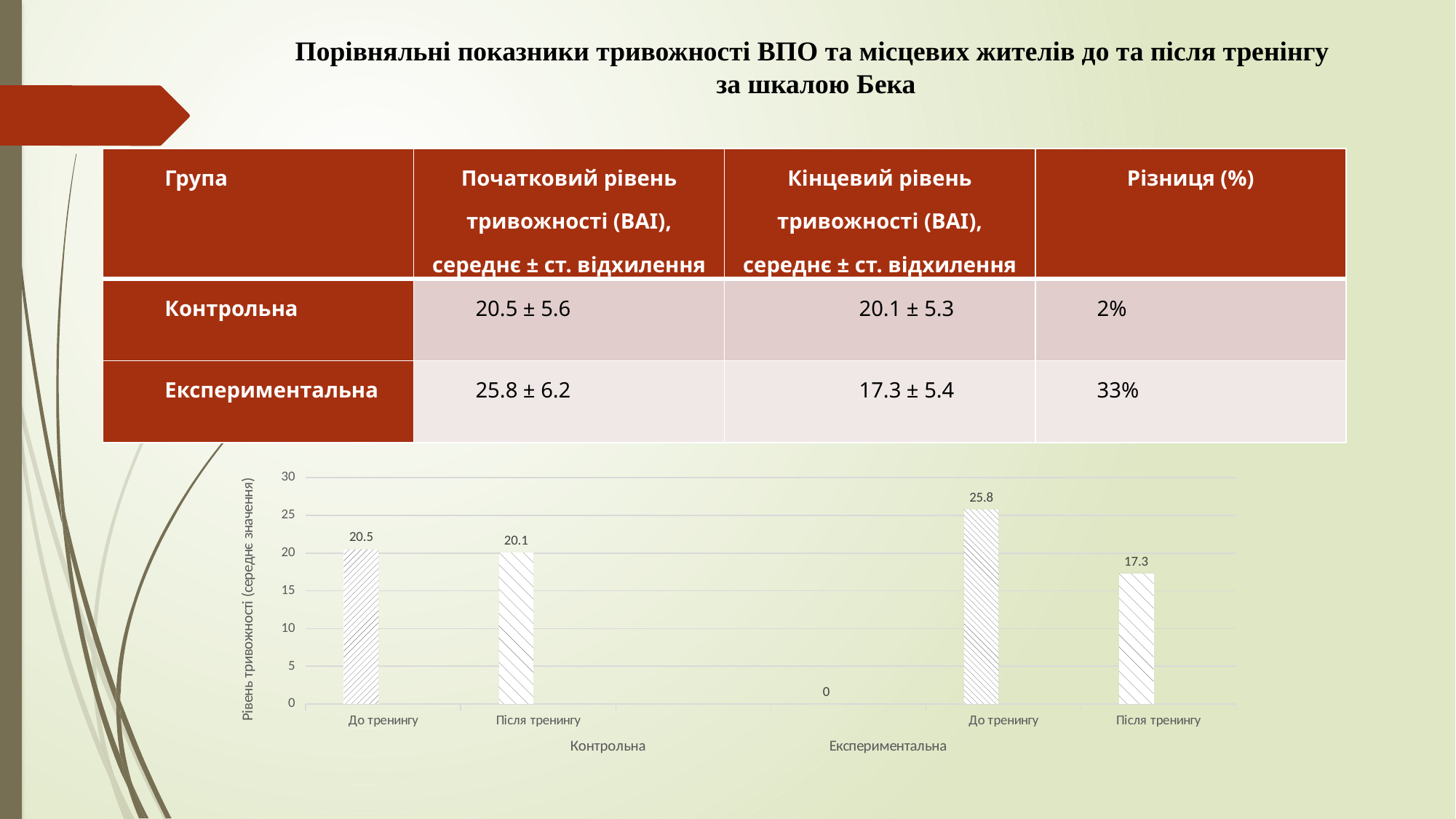
In the chart, what is the value for the Експериментальна group Після тренингу? 17.3 Which bar in the chart has the lowest non-zero value? Експериментальна, Після тренингу In the chart, what is the value for the Контрольна group Після тренингу? 20.1 In the chart, what is the difference between the Експериментальна group's values До тренингу and Після тренингу? 8.5 What type of chart is shown on the slide? bar chart In the chart, what is the value for the Експериментальна group До тренингу? 25.8 In the chart, what is the value for the Контрольна group До тренингу? 20.5 What is the label of the vertical axis of the chart? Рівень тривожності (середнє значення) In the chart, which is larger: the Експериментальна group До тренингу or the Контрольна group До тренингу? Експериментальна, До тренингу Is the value for the Експериментальна group До тренингу greater or less than 25? greater In the chart, what is the difference between the Контрольна group's values До тренингу and Після тренингу? 0.4 Which bar in the chart has the highest value? Експериментальна, До тренингу